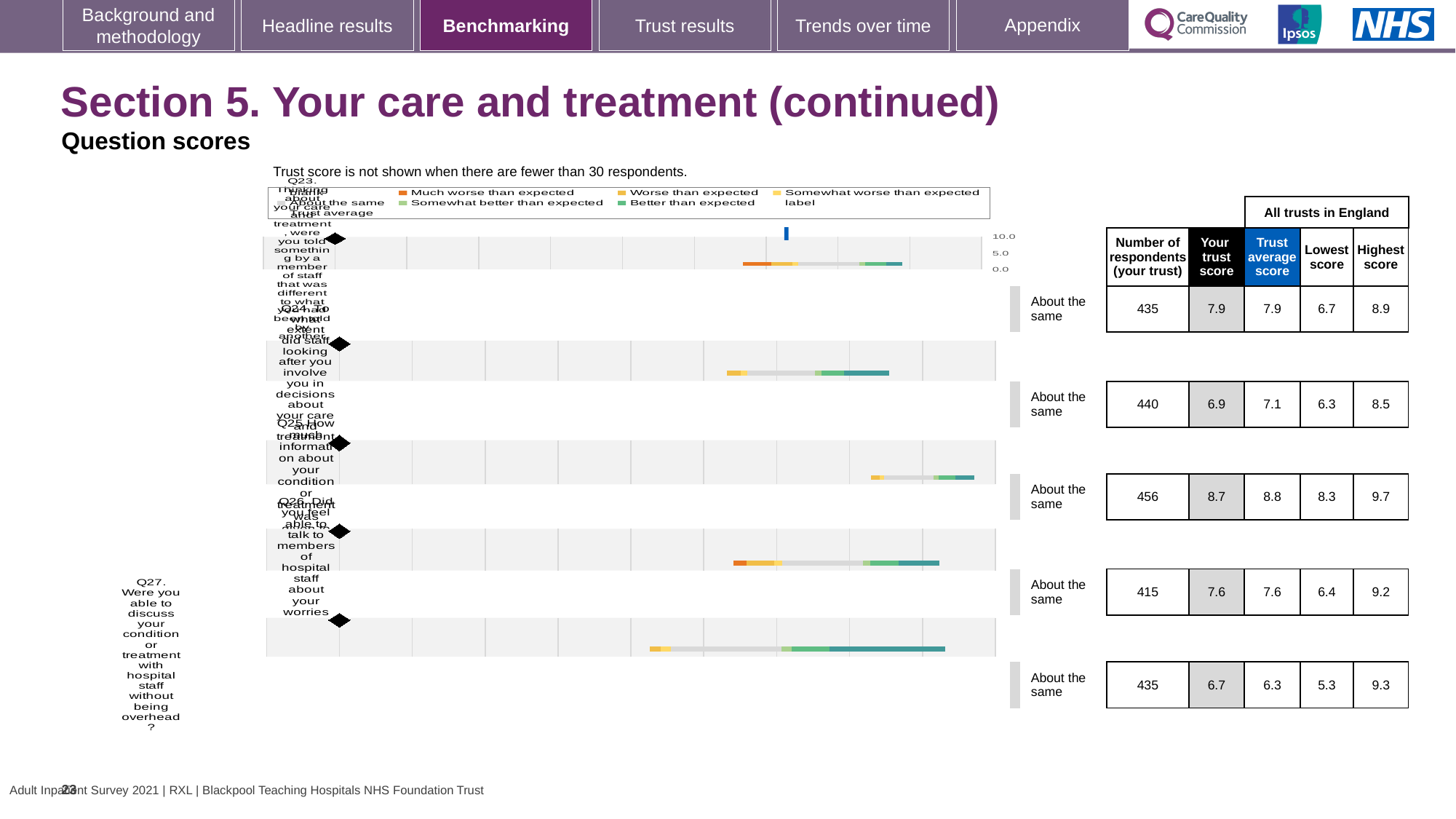
What is the number of respondents for Q27? 435 What is the trust average score for the second question in the chart (Q24)? 7.1 How many questions (bars) are plotted in the chart? 5 What kind of chart is used to show the question scores on this slide? bar chart Which question has the lowest 'Your trust score' in the table? Q27 (6.7) Which question has the highest 'Your trust score' in the table? Q25 (8.7) What is the 'Your trust score' for Q27 (discussing your condition or treatment without being overheard)? 6.7 For Q24, which is larger: the 'Your trust score' or the trust average score? Trust average score What is the difference between the 'Your trust score' and the trust average score for Q27? 0.4 What is the 'Your trust score' for the first question in the chart (Q23)? 7.9 What benchmark category is shown next to every question in the chart? About the same What is the highest score across all trusts in England for Q27? 9.3